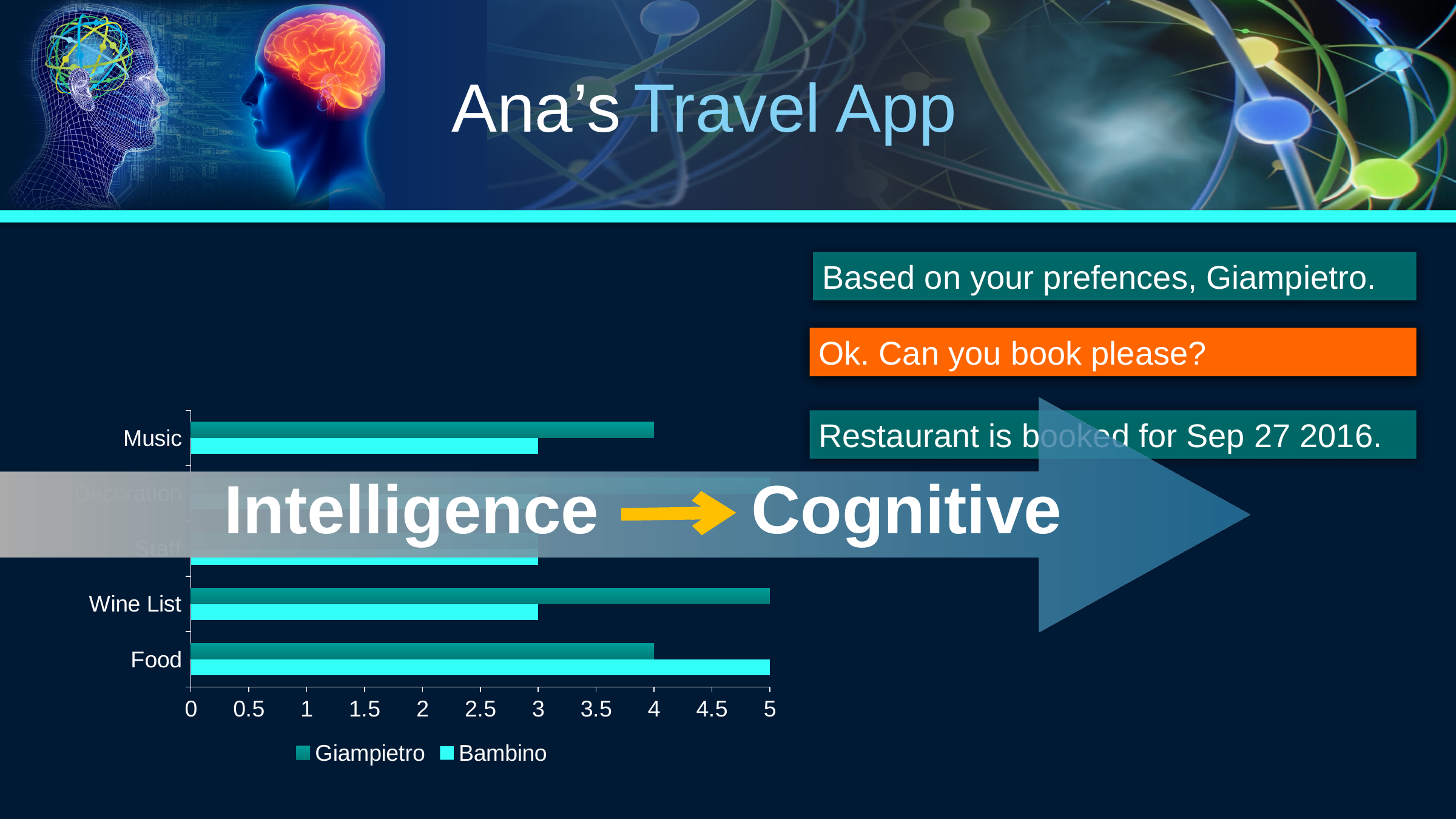
What is the value for Giampietro in the Music category? 4 What are the two series named in the chart legend? Giampietro and Bambino What is the value for Giampietro in the Wine List category? 5 What is the value for Bambino in the Food category? 5 In the Food category, which series has the larger value, Giampietro or Bambino? Bambino In the Music category, which series has the larger value, Giampietro or Bambino? Giampietro What is the value for Bambino in the Wine List category? 3 What is the difference between the Giampietro and Bambino values in the Wine List category? 2 Is the value for Giampietro in the Music category greater or less than 3.5? greater How many categories are shown on the chart's vertical axis? 5 How many series does the chart legend list? 2 What kind of chart is shown on the slide? bar chart